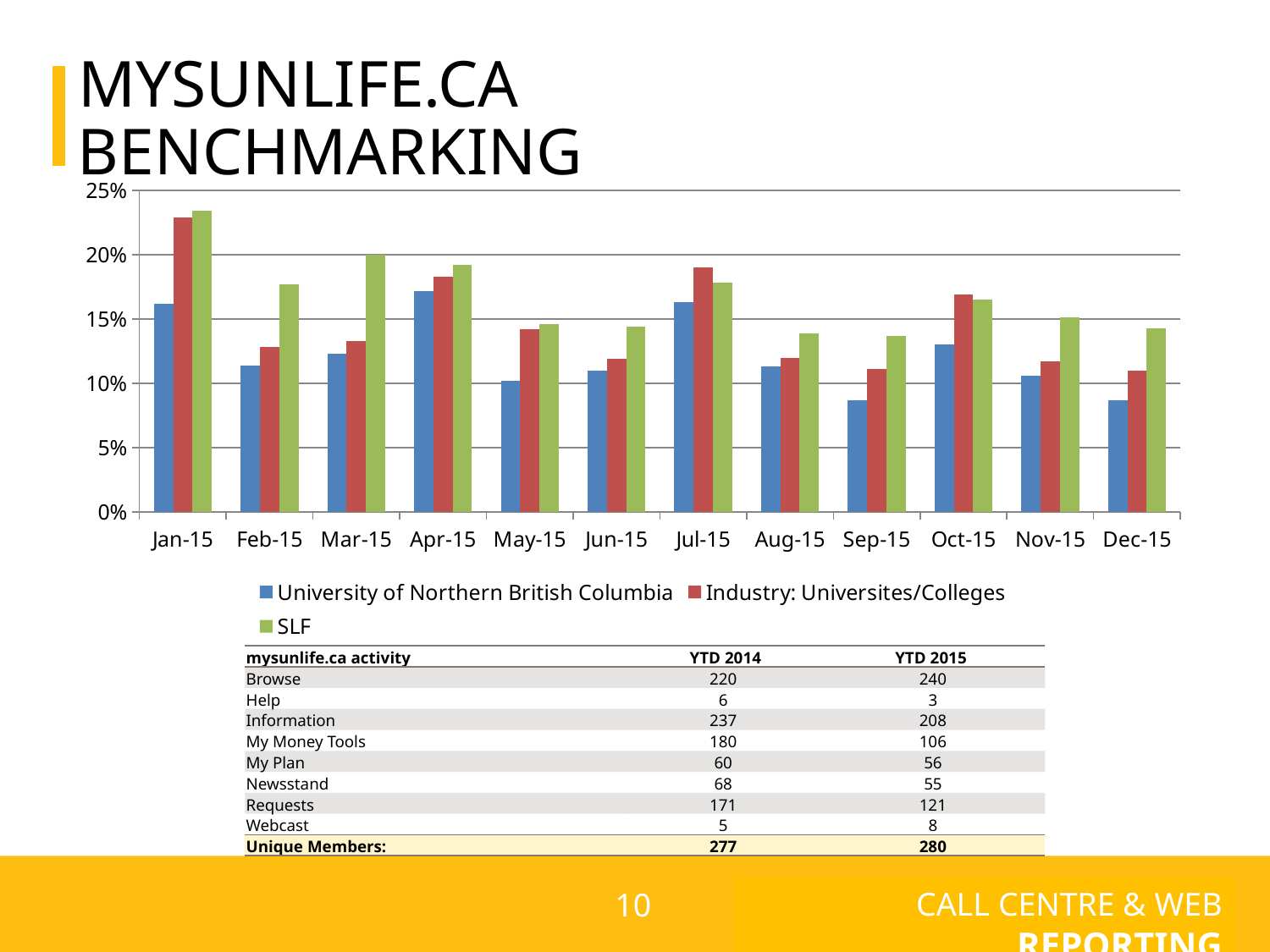
In which month is the Industry: Universites/Colleges value highest? Jan-15 Is the value for Industry: Universites/Colleges in Oct-15 greater or less than 15%? greater How many series does the chart legend list? 3 What kind of chart is shown on the slide? bar chart Is the value for SLF in Feb-15 greater or less than 15%? greater In Mar-15, which is larger: the SLF value or the University of Northern British Columbia value? SLF In Jul-15, which is larger: the Industry: Universites/Colleges value or the SLF value? Industry: Universites/Colleges Is the value for University of Northern British Columbia in Sep-15 greater or less than 10%? less In which month is the SLF value highest? Jan-15 How many months are shown along the x axis of the chart? 12 Which series is shown in green in the chart? SLF